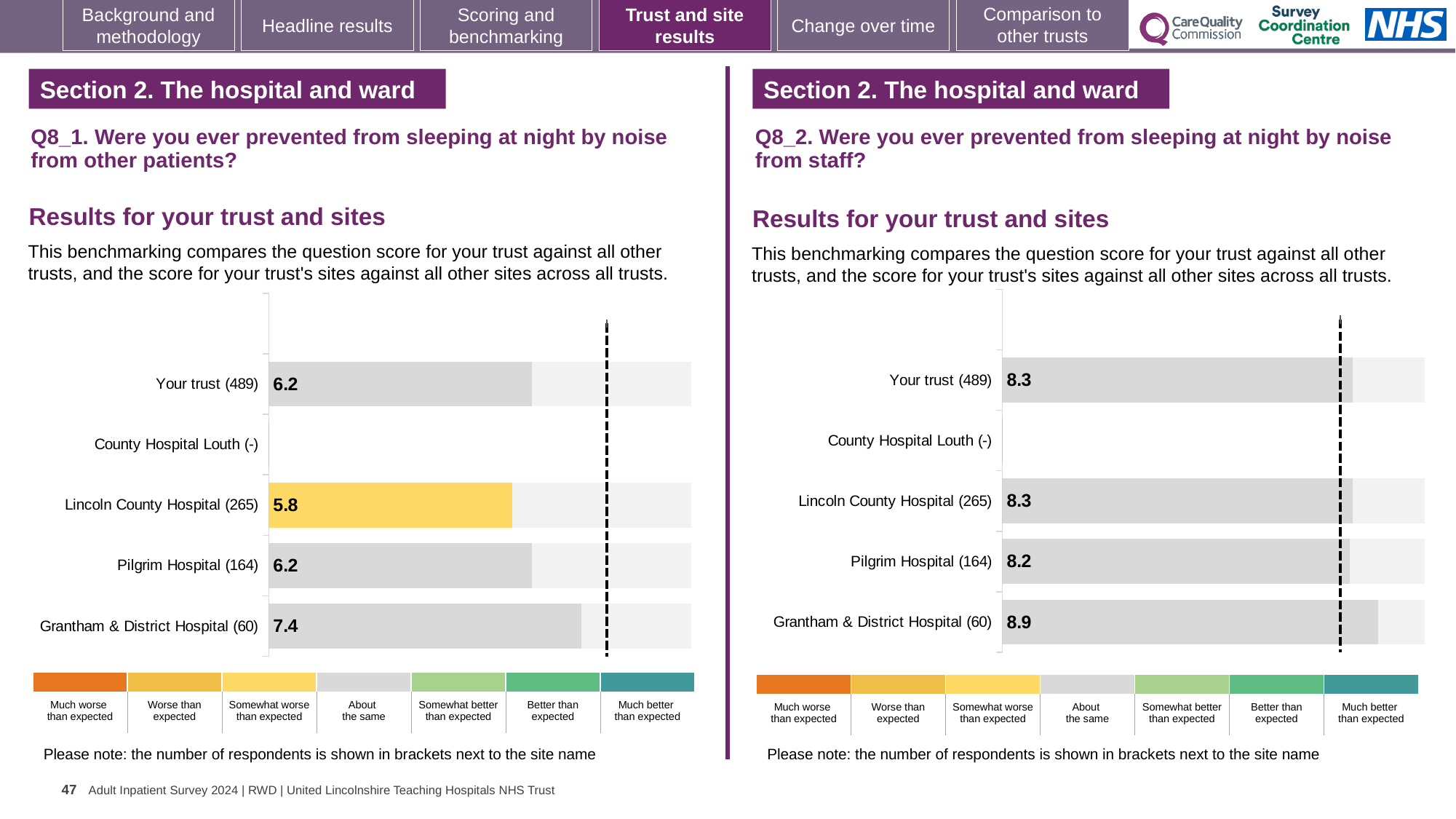
In the Q8_1 chart (left), which site has the highest score? Grantham & District Hospital (60) In the Q8_1 chart (left), which bar is coloured yellow rather than grey? Lincoln County Hospital (265) What kind of chart is used in the Q8_1 chart (left)? bar chart In the Q8_1 chart (left), which site has the lowest score? Lincoln County Hospital (265) In the Q8_1 chart (left), what is the score for Lincoln County Hospital (265)? 5.8 In the Q8_2 chart (right), what is the difference between the scores for Grantham & District Hospital (60) and Pilgrim Hospital (164)? 0.7 In the Q8_1 chart (left), what is the score for Your trust (489)? 6.2 In the Q8_2 chart (right), what is the score for Grantham & District Hospital (60)? 8.9 In the Q8_2 chart (right), what is the score for Pilgrim Hospital (164)? 8.2 In the Q8_2 chart (right), is the score for Your trust (489) larger or smaller than the score for Grantham & District Hospital (60)? smaller In the Q8_1 chart (left), what is the difference between the scores for Grantham & District Hospital (60) and Lincoln County Hospital (265)? 1.6 In the Q8_2 chart (right), which site has the highest score? Grantham & District Hospital (60)